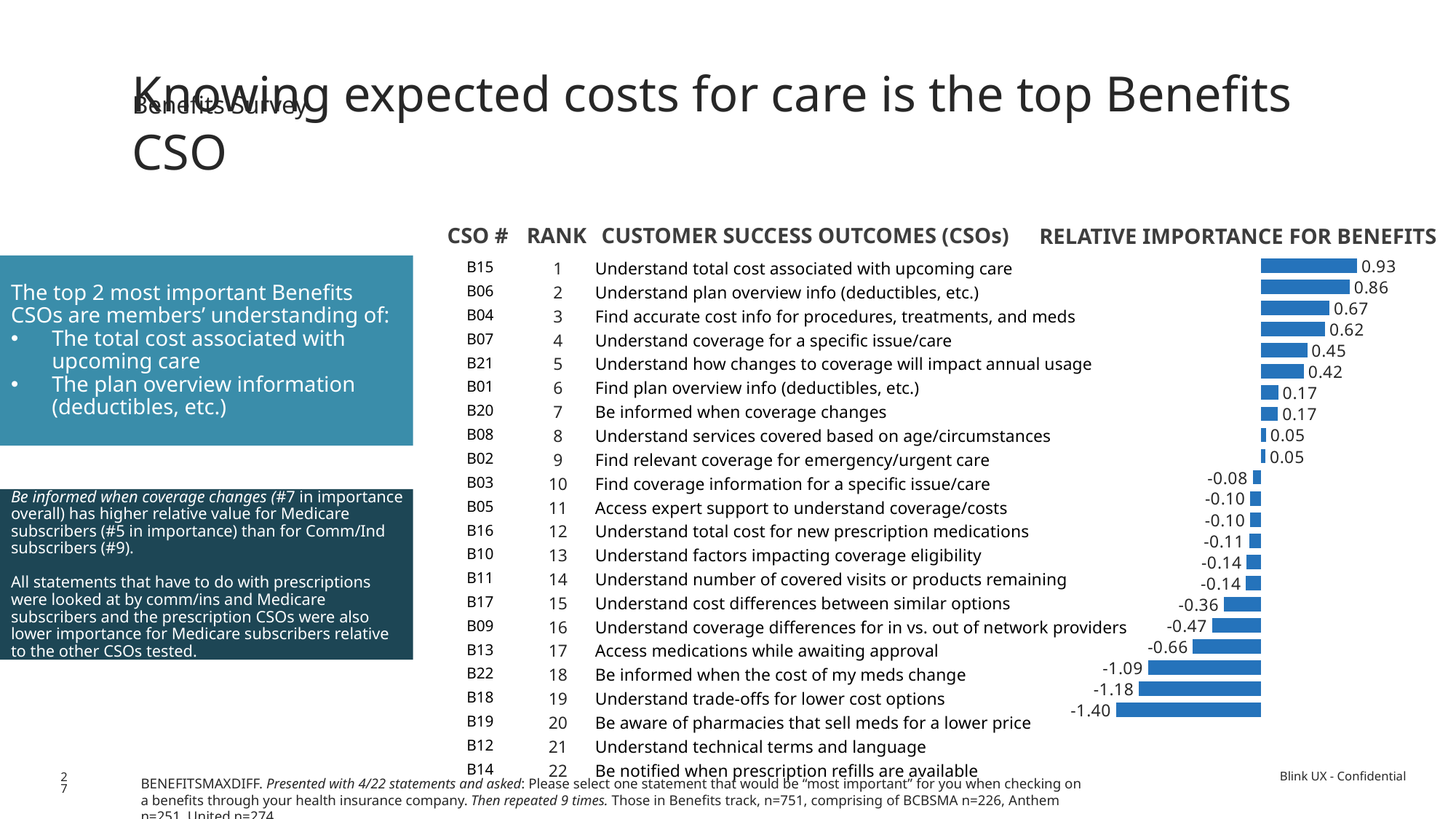
What is the relative importance value for the rank 3 CSO, B04 'Find accurate cost info for procedures, treatments, and meds'? 0.67 How many bars in the chart have a negative relative importance value? 12 What is the difference between the relative importance values of the rank 1 bar (0.93) and the rank 2 bar (0.86)? 0.07 Do the relative importance values rise or fall going down the chart from rank 1 to rank 22? fall Which is larger: the relative importance for rank 5 (B21) or rank 6 (B01)? rank 5 (B21), 0.45 What is the relative importance value for the top-ranked CSO, B15 'Understand total cost associated with upcoming care'? 0.93 How many bars are plotted in the Relative Importance for Benefits chart? 22 What is the relative importance value for the rank 2 CSO, B06 'Understand plan overview info (deductibles, etc.)'? 0.86 Which CSO has the highest relative importance for Benefits? B15 (Understand total cost associated with upcoming care) What is the relative importance value for the rank 21 CSO, B12 'Understand technical terms and language'? -1.18 What type of chart is shown under 'Relative Importance for Benefits'? bar chart What is the lowest relative importance value shown in the chart? -1.40